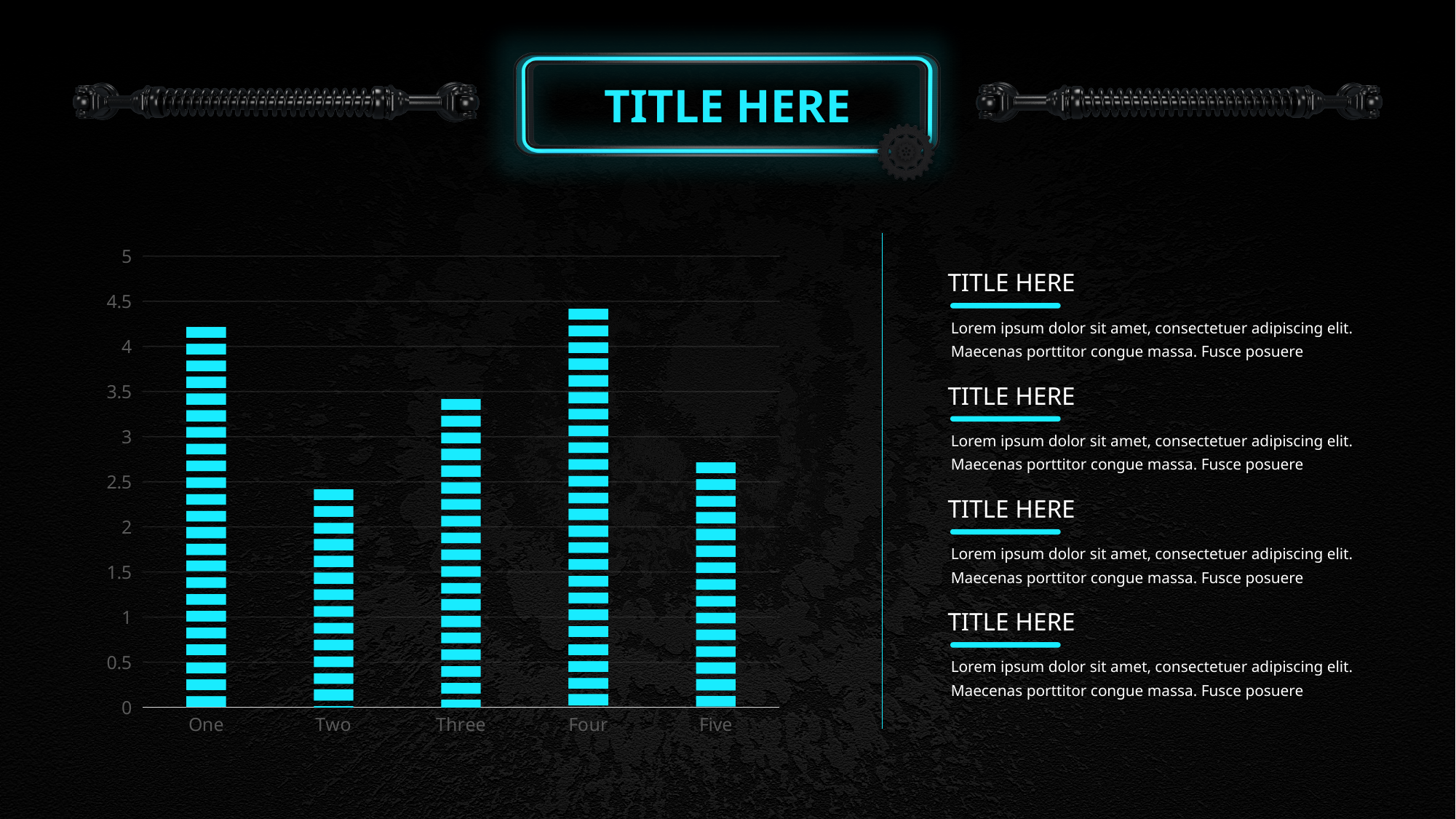
Is the value for Five greater or less than 3? less Is the value for Four greater or less than 4? greater What kind of chart is shown on the slide? bar chart Which is larger, the value for Five or the value for Two? Five Is the value for Three greater or less than 3? greater Which category has the lowest bar? Two How many categories are plotted on the chart? 5 What colour are the bars in the chart? cyan Which category has the highest bar? Four Which is larger, the value for One or the value for Three? One